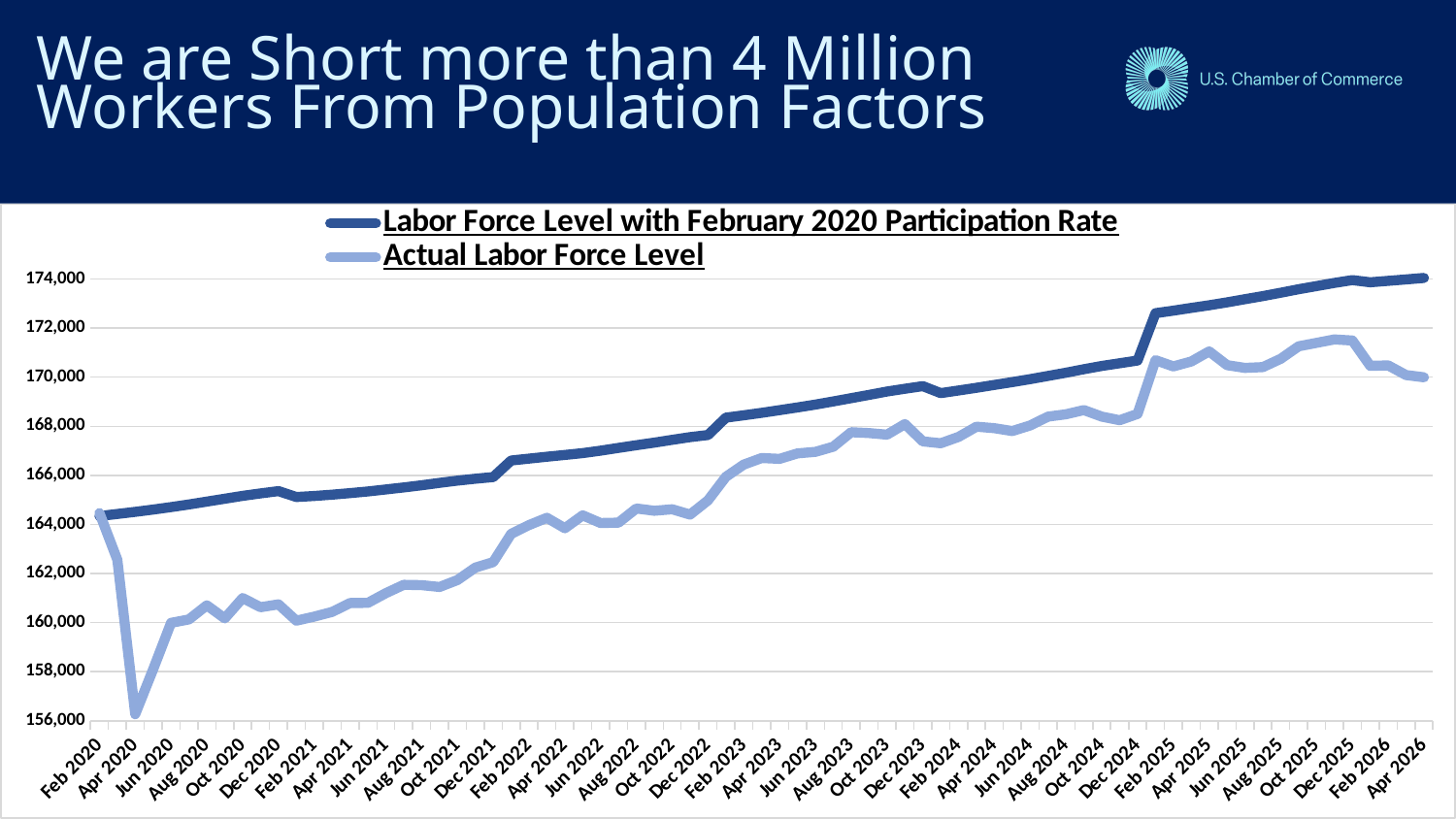
Does the Labor Force Level with February 2020 Participation Rate generally rise or fall from Feb 2020 to Apr 2026? rise What are the two series named in the legend? Labor Force Level with February 2020 Participation Rate; Actual Labor Force Level What kind of chart is shown on the slide? line chart How many series does the legend list? 2 Is the Actual Labor Force Level in Apr 2026 greater or less than 168,000? greater Which series is drawn in the darker blue line? Labor Force Level with February 2020 Participation Rate At which month does the Actual Labor Force Level reach its lowest point? Apr 2020 Is the Labor Force Level with February 2020 Participation Rate in Apr 2026 greater or less than 172,000? greater Is the Labor Force Level with February 2020 Participation Rate in Feb 2020 greater or less than 162,000? greater In Apr 2026, which series is higher: Labor Force Level with February 2020 Participation Rate or Actual Labor Force Level? Labor Force Level with February 2020 Participation Rate